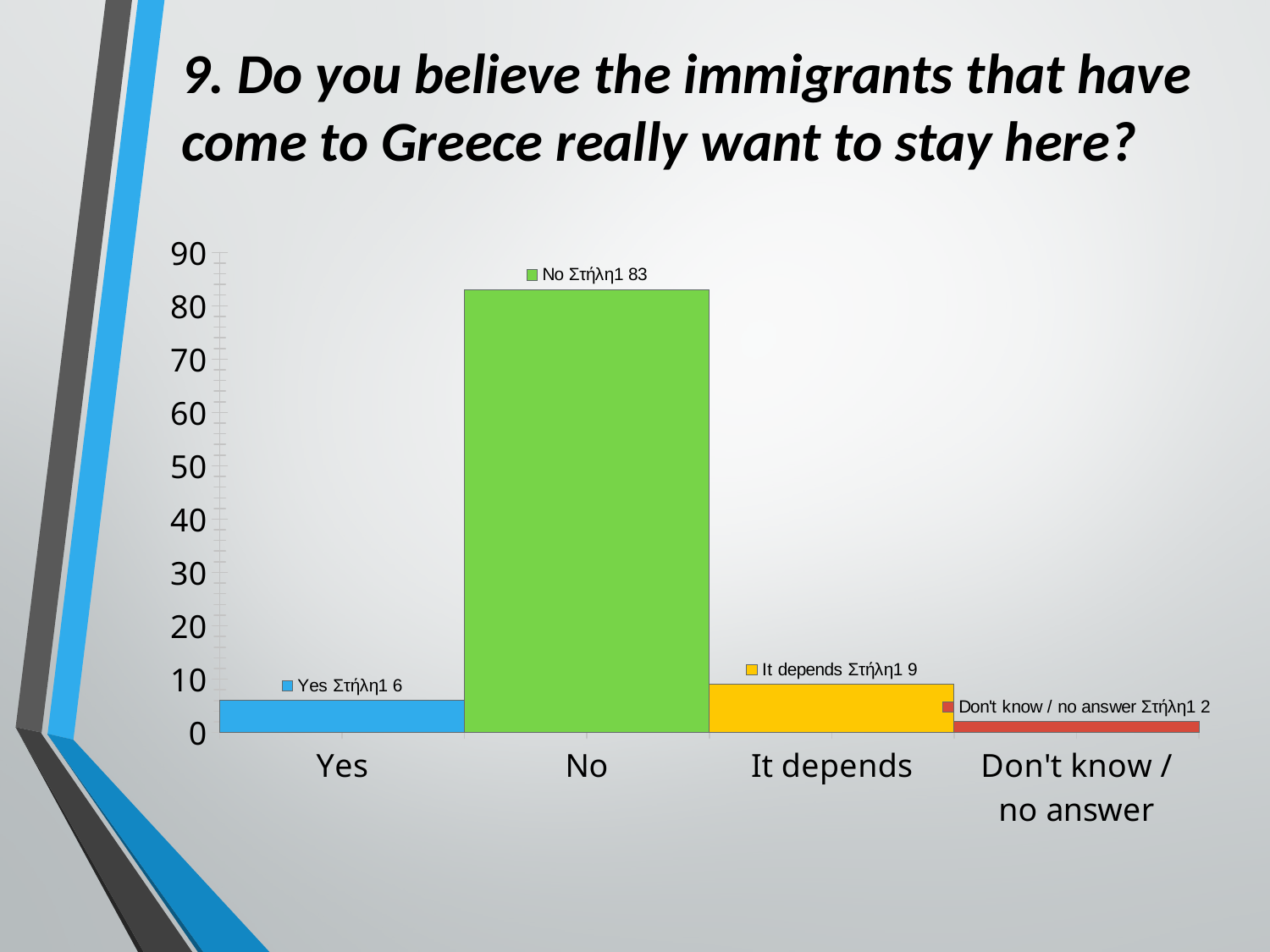
What kind of chart is shown on the slide? bar chart Which category has the lowest value? Don't know / no answer Is the value for "No" greater or less than 80? greater What is the difference between the values for "No" and "It depends"? 74 Which category has the highest value? No How many categories are shown on the x axis? 4 What is the value for "Don't know / no answer"? 2 What is the value for "Yes"? 6 What colour is the bar for "No"? green What is the value for "No"? 83 What is the value for "It depends"? 9 Which is larger, the value for "Yes" or the value for "It depends"? It depends